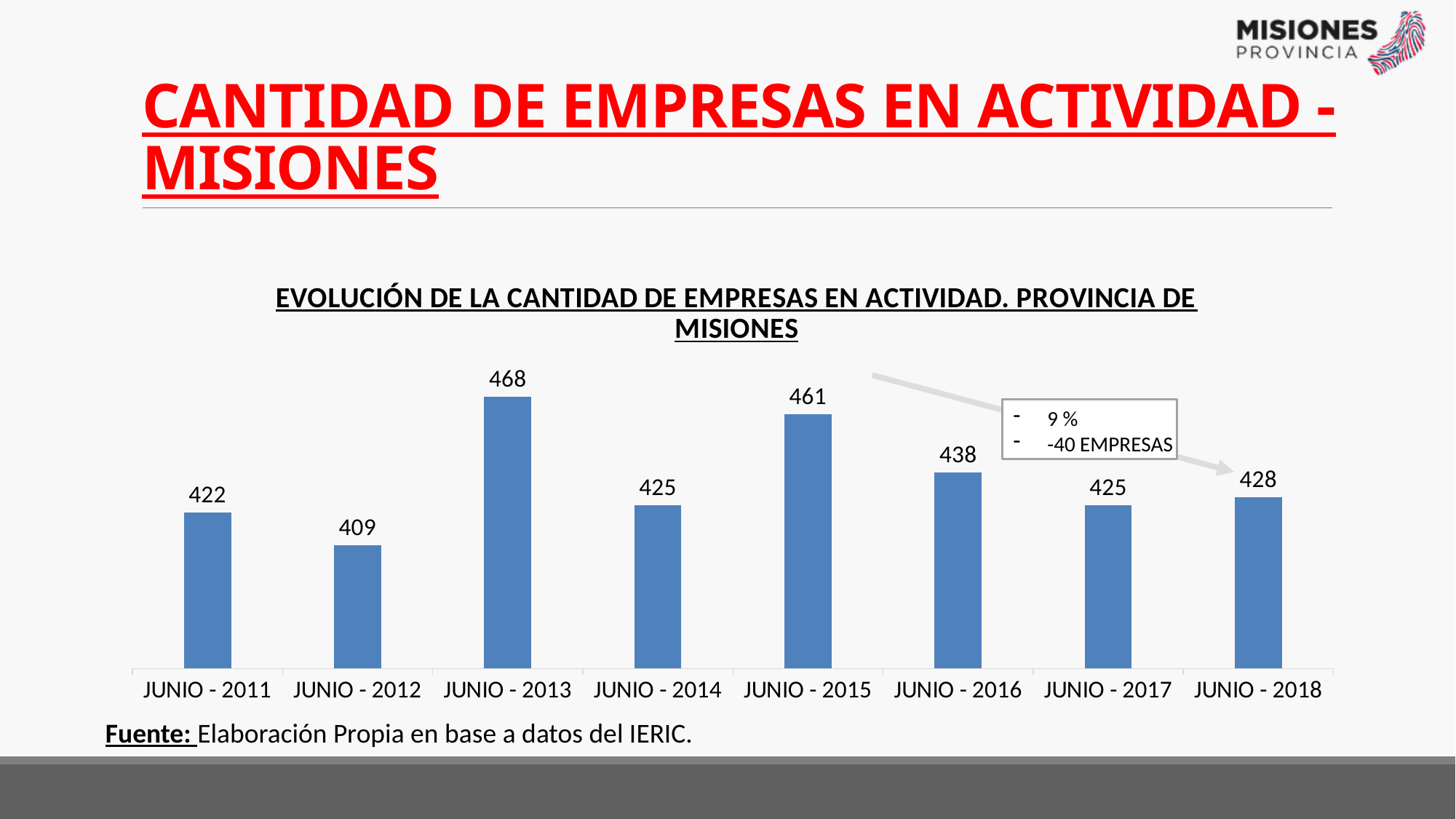
What is the difference between the values for JUNIO - 2013 and JUNIO - 2012? 59 Which category has the highest value? JUNIO - 2013 What kind of chart is shown on the slide? Bar chart Which is larger, the value for JUNIO - 2011 or the value for JUNIO - 2016? JUNIO - 2016 What is the value for JUNIO - 2018? 428 What is the difference between the values for JUNIO - 2015 and JUNIO - 2016? 23 Which category has the lowest value? JUNIO - 2012 What is the title of the chart? EVOLUCIÓN DE LA CANTIDAD DE EMPRESAS EN ACTIVIDAD. PROVINCIA DE MISIONES What is the value for JUNIO - 2013? 468 What is the value for JUNIO - 2012? 409 Do the values rise or fall from JUNIO - 2015 to JUNIO - 2017? Fall How many categories are shown on the x axis? 8